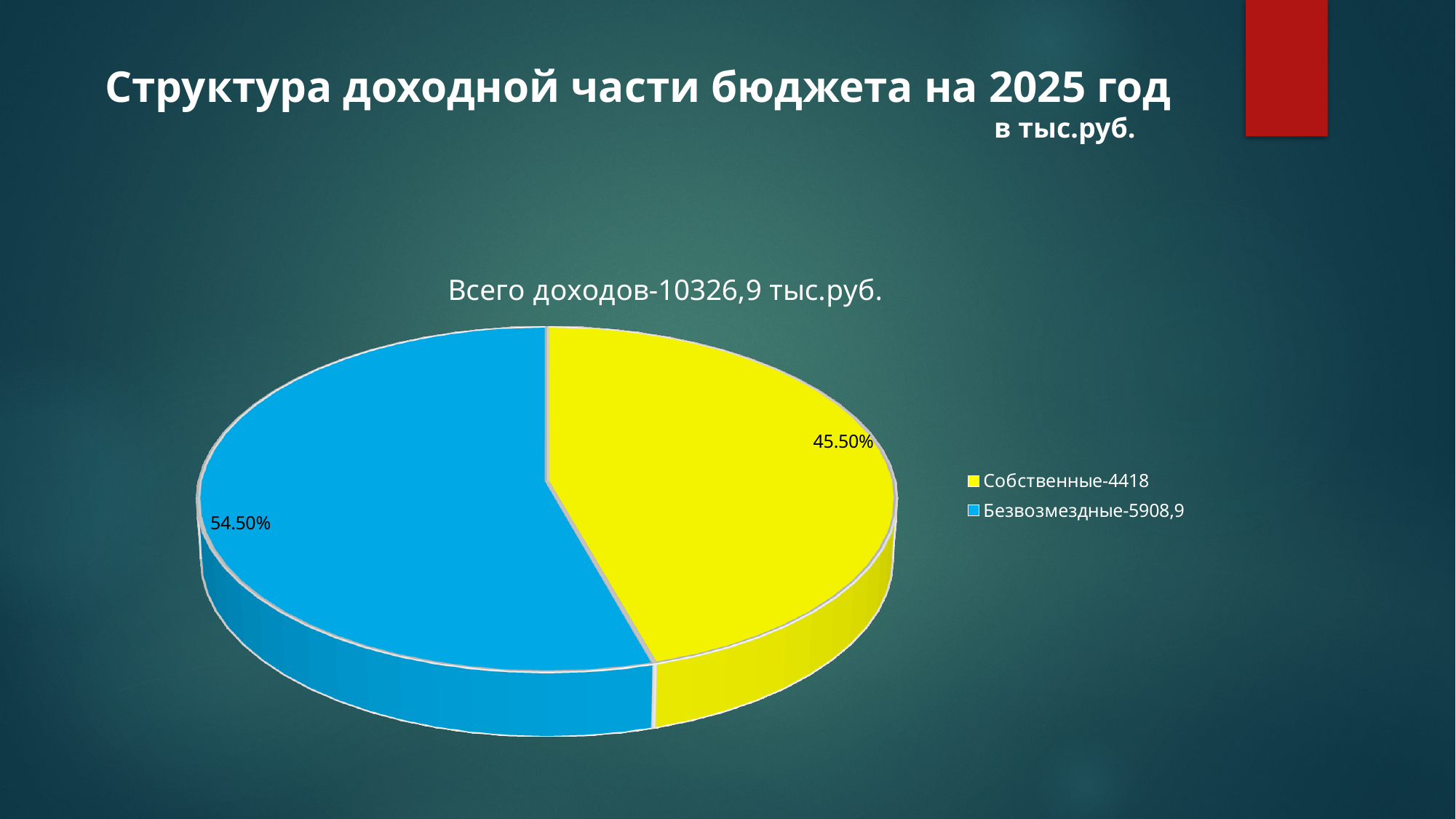
Which slice is the smallest? Собственные What kind of chart is shown on the slide? pie chart What share of the pie does the Собственные slice represent? 45.50% What is the difference in percentage points between the Безвозмездные and Собственные slices? 9 percentage points What value is given for Безвозмездные in the legend? 5908,9 What value is given for Собственные in the legend? 4418 Which is larger, the Собственные slice or the Безвозмездные slice? Безвозмездные Which slice is the largest? Безвозмездные What share of the pie does the Безвозмездные slice represent? 54.50% How many slices does the pie chart have? 2 What colour is the Собственные slice? yellow What is the chart's title? Всего доходов-10326,9 тыс.руб.